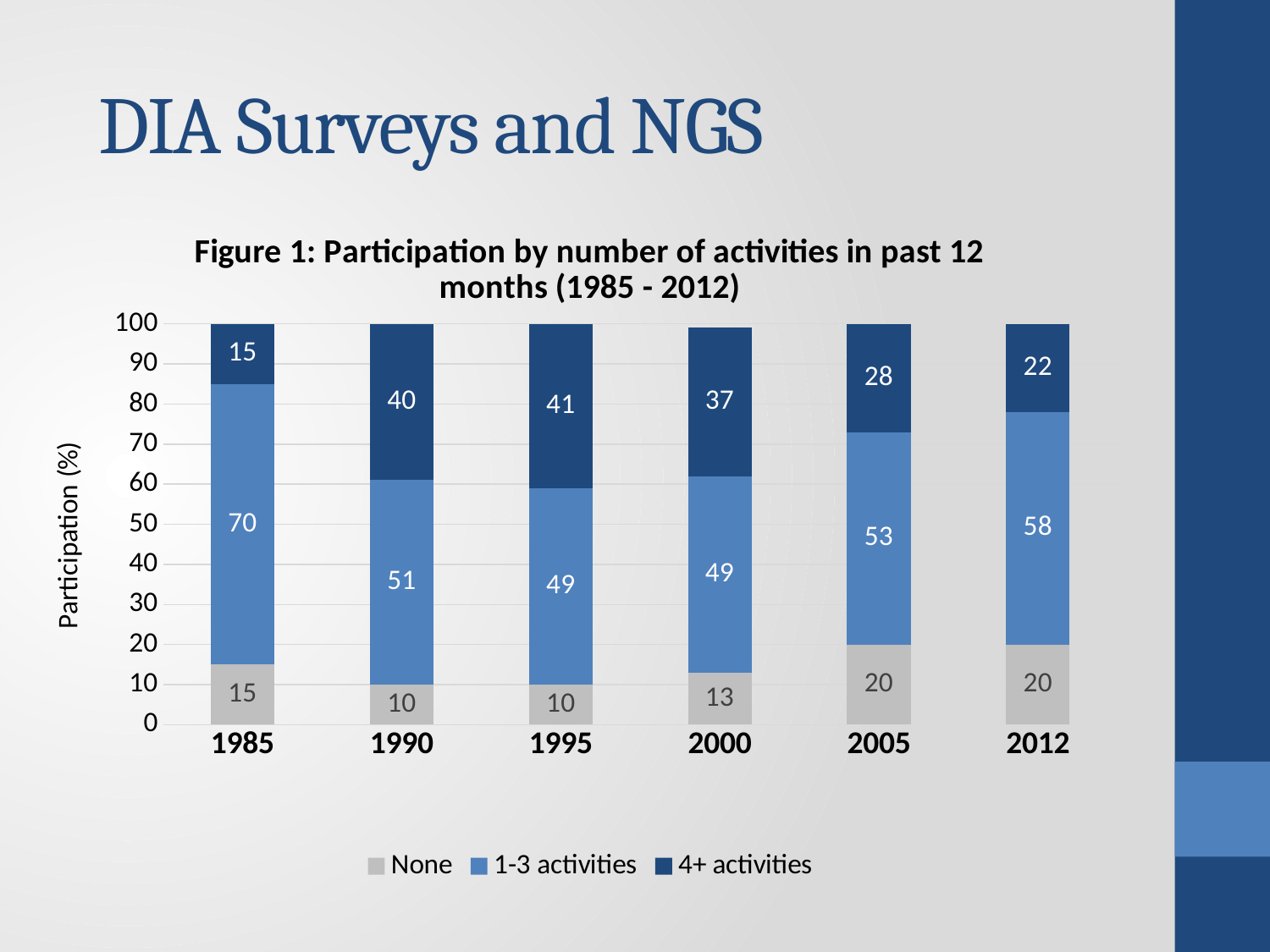
Which is larger, the 'None' value in 2005 or the 'None' value in 1990? 2005 What type of chart is shown on the slide? Stacked bar chart How many series does the legend list? 3 What is the difference between the '4+ activities' values in 1990 and 2012? 18 What is the value for 'None' in 2000? 13 What is the value for '1-3 activities' in 1985? 70 What is the value for '4+ activities' in 1995? 41 What is the title of the chart? Figure 1: Participation by number of activities in past 12 months (1985 - 2012) In which year is the '4+ activities' value highest? 1995 What is the total of the stacked bar for 2005? 101 How many years are shown on the x axis? 6